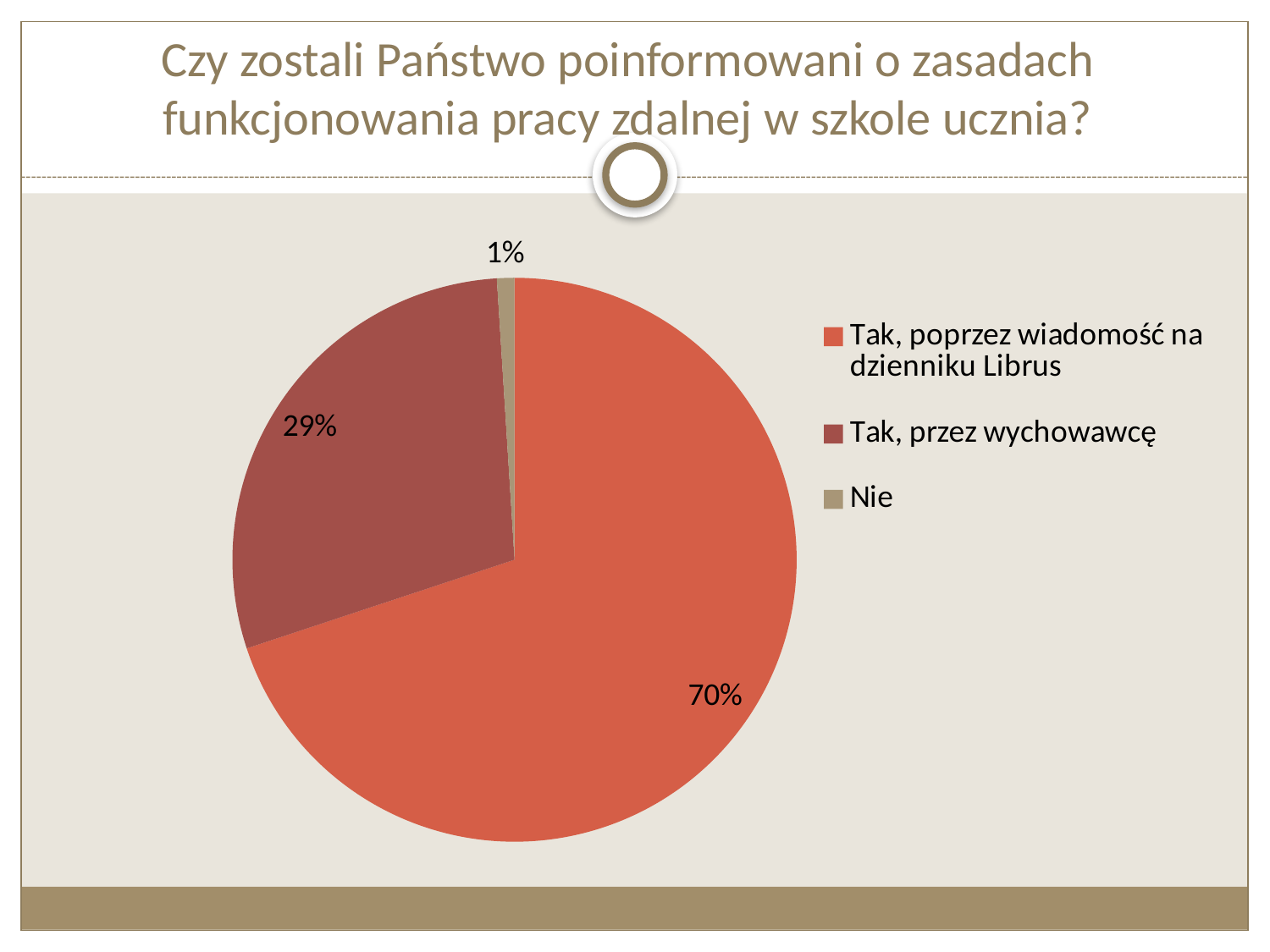
How many categories does the pie chart have? 3 What share of the pie does "Tak, przez wychowawcę" have? 29% Which is larger: the slice for "Tak, przez wychowawcę" or the slice for "Nie"? Tak, przez wychowawcę Which category has the largest slice of the pie? Tak, poprzez wiadomość na dzienniku Librus What share of the pie does "Tak, poprzez wiadomość na dzienniku Librus" have? 70% What is the title of the slide containing the pie chart? Czy zostali Państwo poinformowani o zasadach funkcjonowania pracy zdalnej w szkole ucznia? Which category has the smallest slice of the pie? Nie What type of chart is shown on the slide? pie chart What is the difference in percentage points between "Tak, przez wychowawcę" and "Nie"? 28 percentage points Which legend entry is shown in the tan/beige colour? Nie What share of the pie does "Nie" have? 1% What is the difference in percentage points between "Tak, poprzez wiadomość na dzienniku Librus" and "Tak, przez wychowawcę"? 41 percentage points